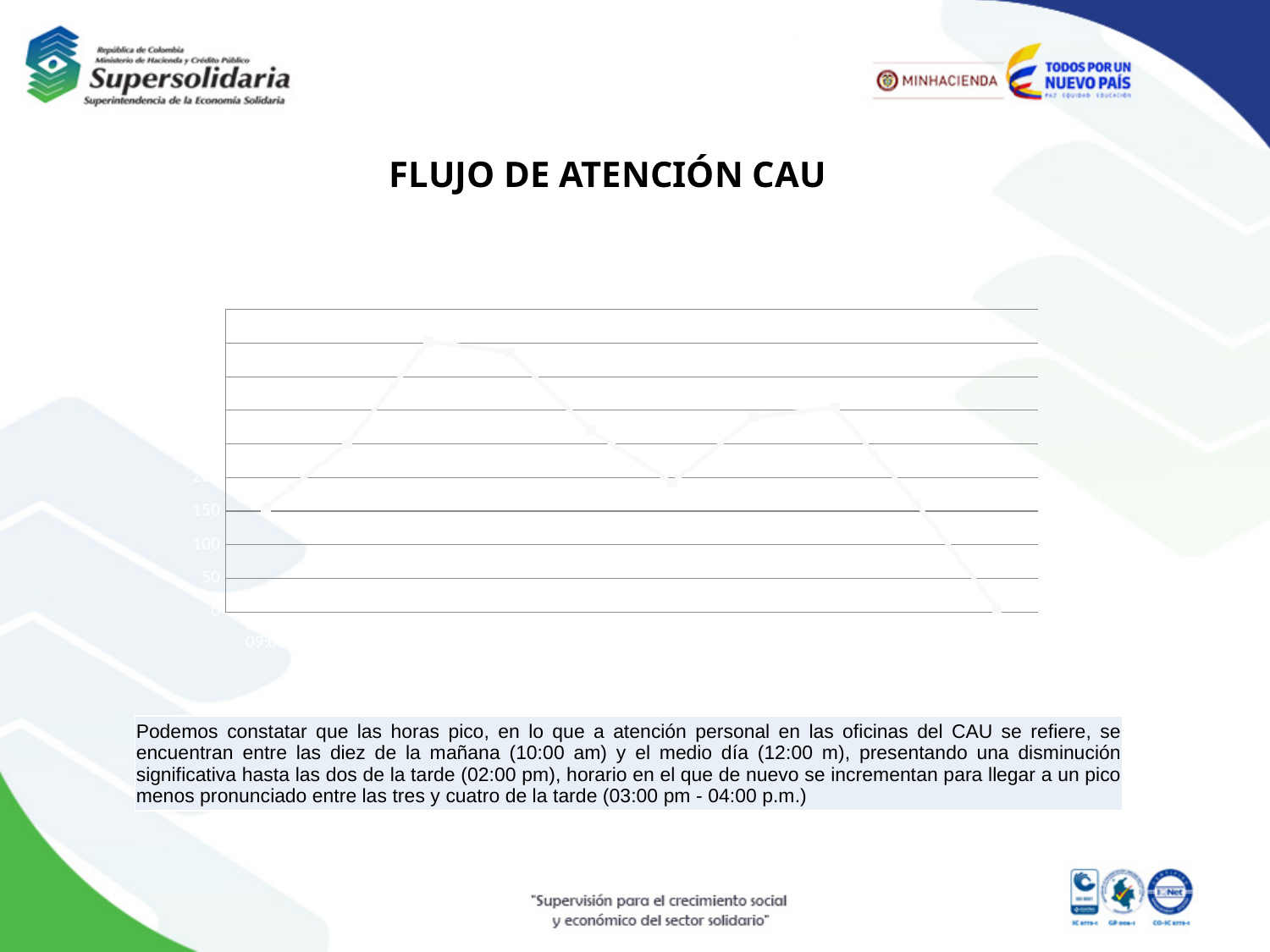
Does the line rise or fall between the last two points on the right of the chart? fall What kind of chart is shown on the slide? line chart What is the title shown above the chart? FLUJO DE ATENCIÓN CAU What is the lowest value labelled on the vertical axis of the chart? 0